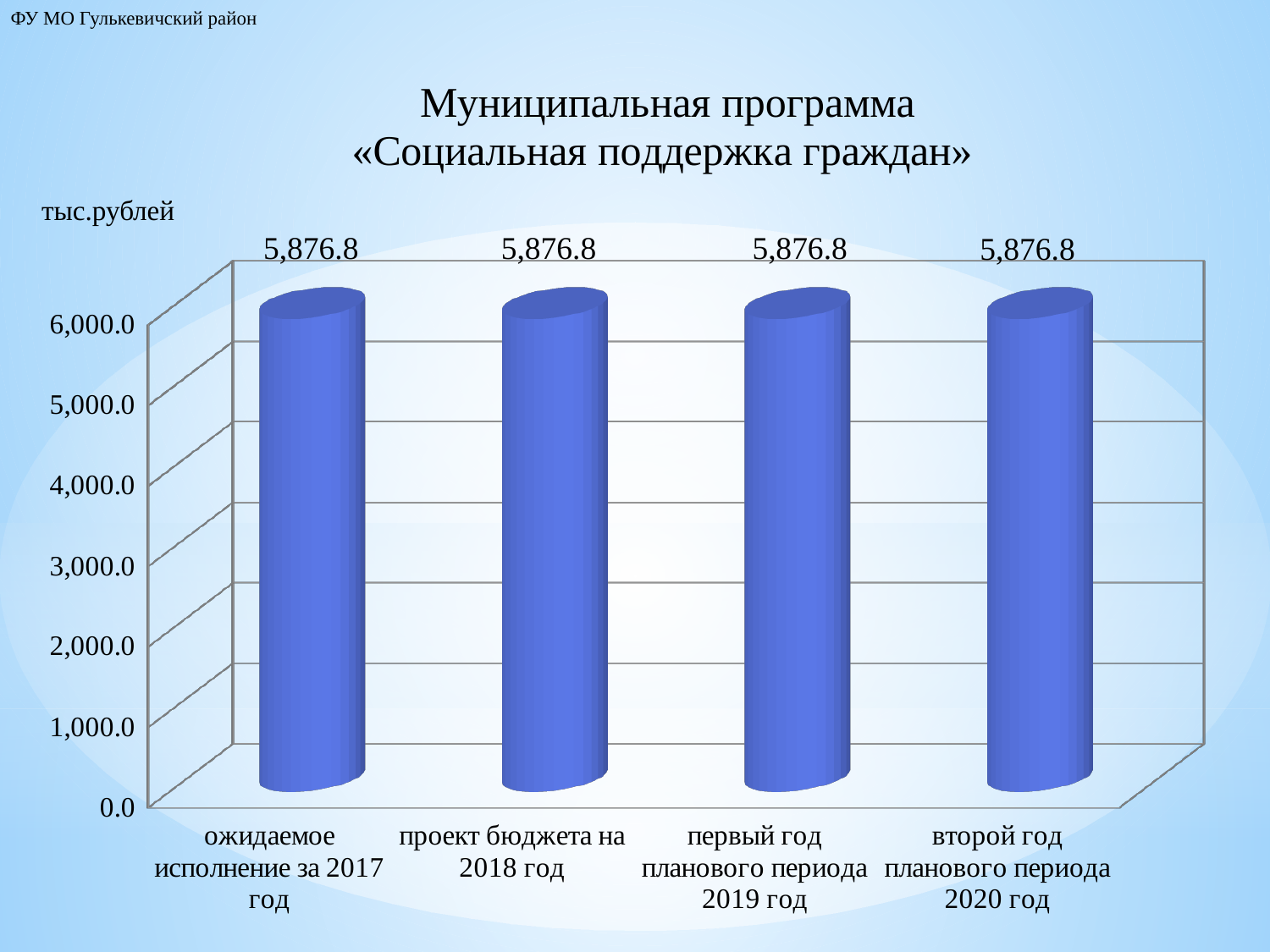
Is the value for «второй год планового периода 2020 год» greater or less than 5,000.0? greater What is the value for «проект бюджета на 2018 год»? 5,876.8 Do the values rise, fall, or stay the same from 2017 to 2020? stay the same Is the value for «проект бюджета на 2018 год» greater or less than 6,000.0? less What is the value for «первый год планового периода 2019 год»? 5,876.8 What is the title of the chart? Муниципальная программа «Социальная поддержка граждан» What kind of chart is shown on the slide? bar chart What is the value for «ожидаемое исполнение за 2017 год»? 5,876.8 How many categories are shown on the x axis of the chart? 4 What is the value for «второй год планового периода 2020 год»? 5,876.8 In what units are the values on the chart expressed? тыс.рублей What is the difference between the value for 2018 and the value for 2020? 0.0